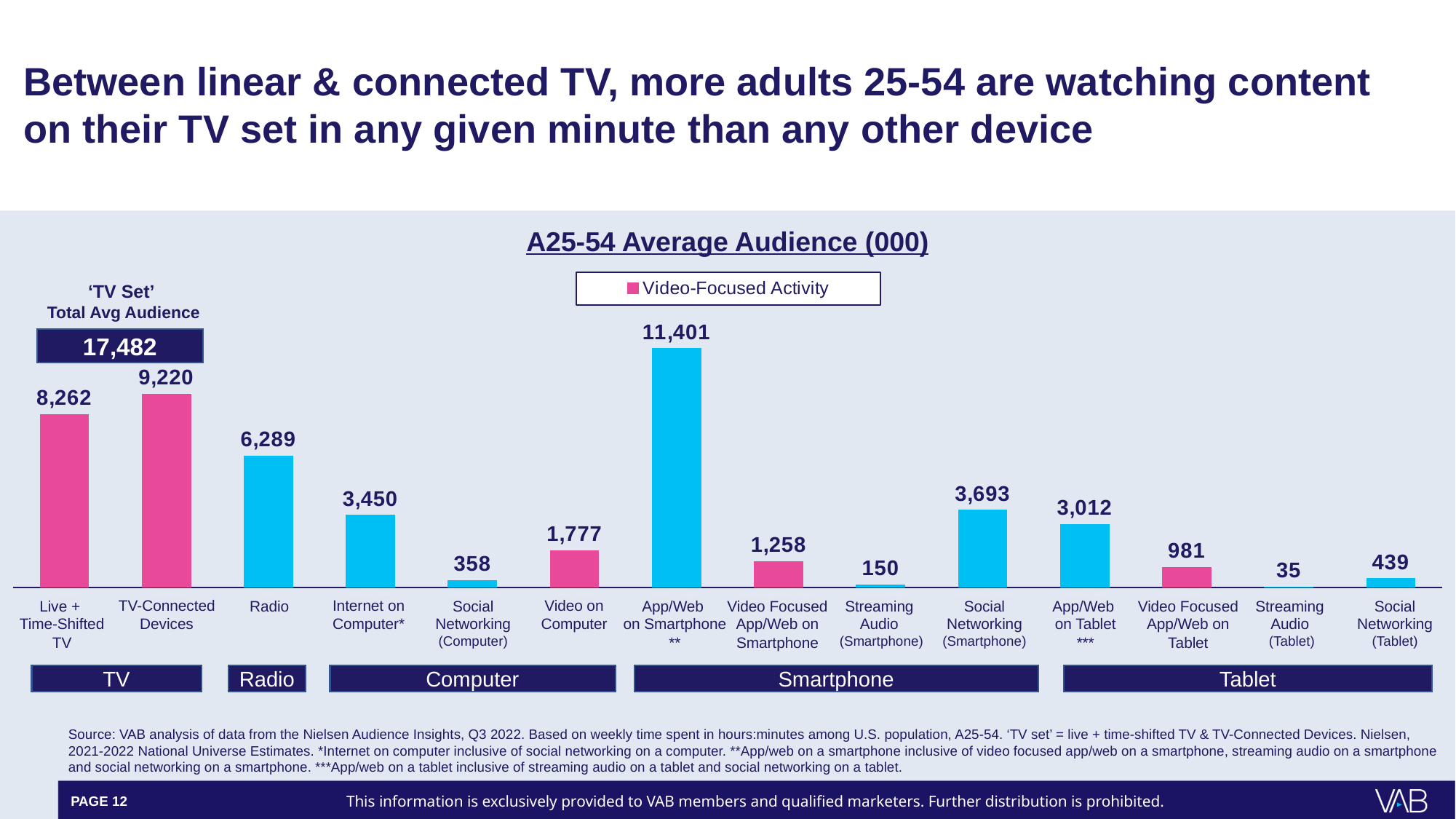
What is the value for Video Focused App/Web on Tablet? 981 What is the difference between Social Networking (Smartphone) and App/Web on Tablet? 681 What type of chart is shown? Bar chart What is the value for App/Web on Smartphone? 11,401 Which category has the lowest value? Streaming Audio (Tablet) Which is larger, Video on Computer or Video Focused App/Web on Smartphone? Video on Computer What is the difference between TV-Connected Devices and Live + Time-Shifted TV? 958 Which category has the highest value? App/Web on Smartphone How many categories are plotted in the chart? 14 What is the 'TV Set' Total Avg Audience shown above the TV bars? 17,482 What is the value for Radio? 6,289 What is the value for Social Networking (Computer)? 358